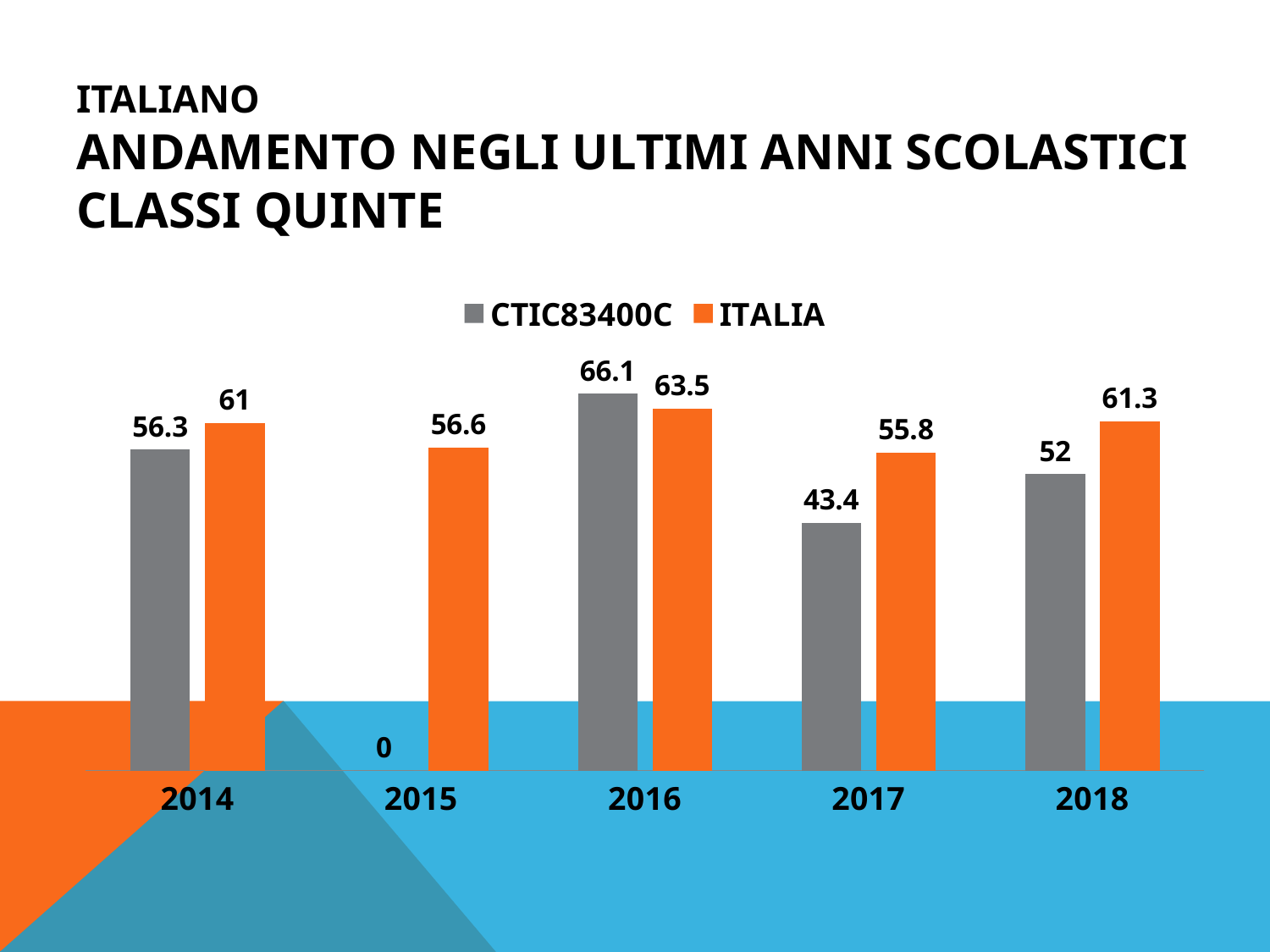
Excluding the 0 in 2015, in which year is the CTIC83400C value lowest? 2017 In which year is the ITALIA value highest? 2016 Does the ITALIA value rise or fall from 2017 to 2018? Rise What is the value for CTIC83400C in 2015? 0 How many series does the legend list? 2 What is the difference between the ITALIA and CTIC83400C values in 2017? 12.4 How many years are shown on the x axis? 5 Which is larger in 2016, CTIC83400C or ITALIA? CTIC83400C What kind of chart is shown on the slide? Bar chart What is the value for ITALIA in 2018? 61.3 What is the value for CTIC83400C in 2016? 66.1 Which colour represents the ITALIA series? Orange